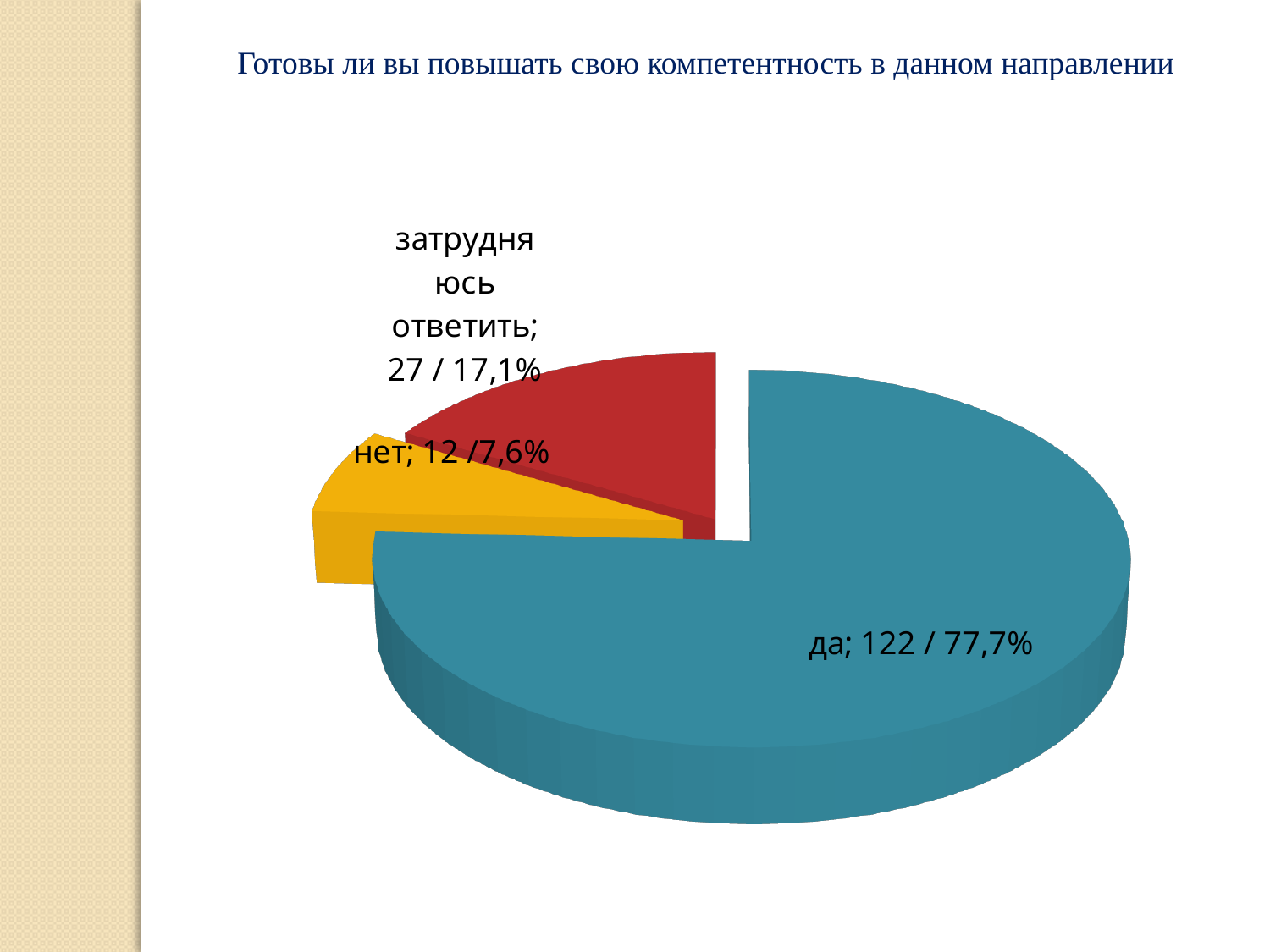
What percentage share does the "затрудняюсь ответить" slice have? 17,1% What is the count shown for the "затрудняюсь ответить" slice? 27 What percentage share does the "нет" slice have? 7,6% What is the count shown for the "да" slice? 122 What percentage share does the "да" slice have? 77,7% What is the title of the chart? Готовы ли вы повышать свою компетентность в данном направлении How many slices does the pie chart have? 3 What kind of chart is shown on the slide? pie chart Which slice is the largest? да Which slice is the smallest? нет What is the count shown for the "нет" slice? 12 What is the difference in count between the "да" slice and the "затрудняюсь ответить" slice? 95